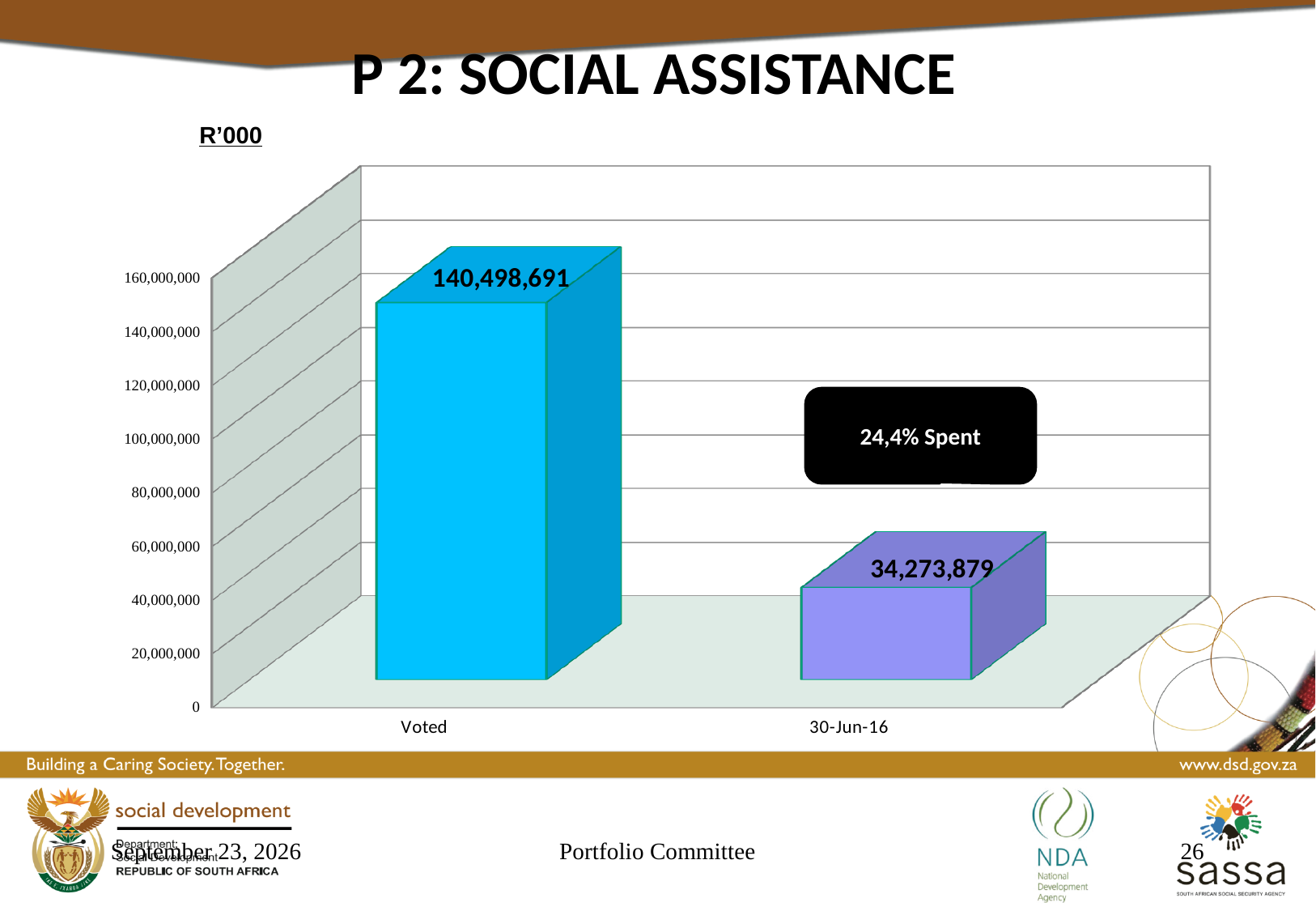
What is the difference between the Voted value and the 30-Jun-16 value? 106,224,812 Is the value for 30-Jun-16 greater or less than 40,000,000? less What kind of chart is shown on the slide? bar chart Which category has the lowest value? 30-Jun-16 How many categories are shown on the x axis? 2 What unit label is shown above the chart? R'000 What is the value for Voted? 140,498,691 Which is larger, the value for Voted or the value for 30-Jun-16? Voted Is the value for Voted greater or less than 120,000,000? greater Which category has the highest value? Voted What percentage spent is shown in the callout on the chart? 24,4% Spent What is the value for 30-Jun-16? 34,273,879